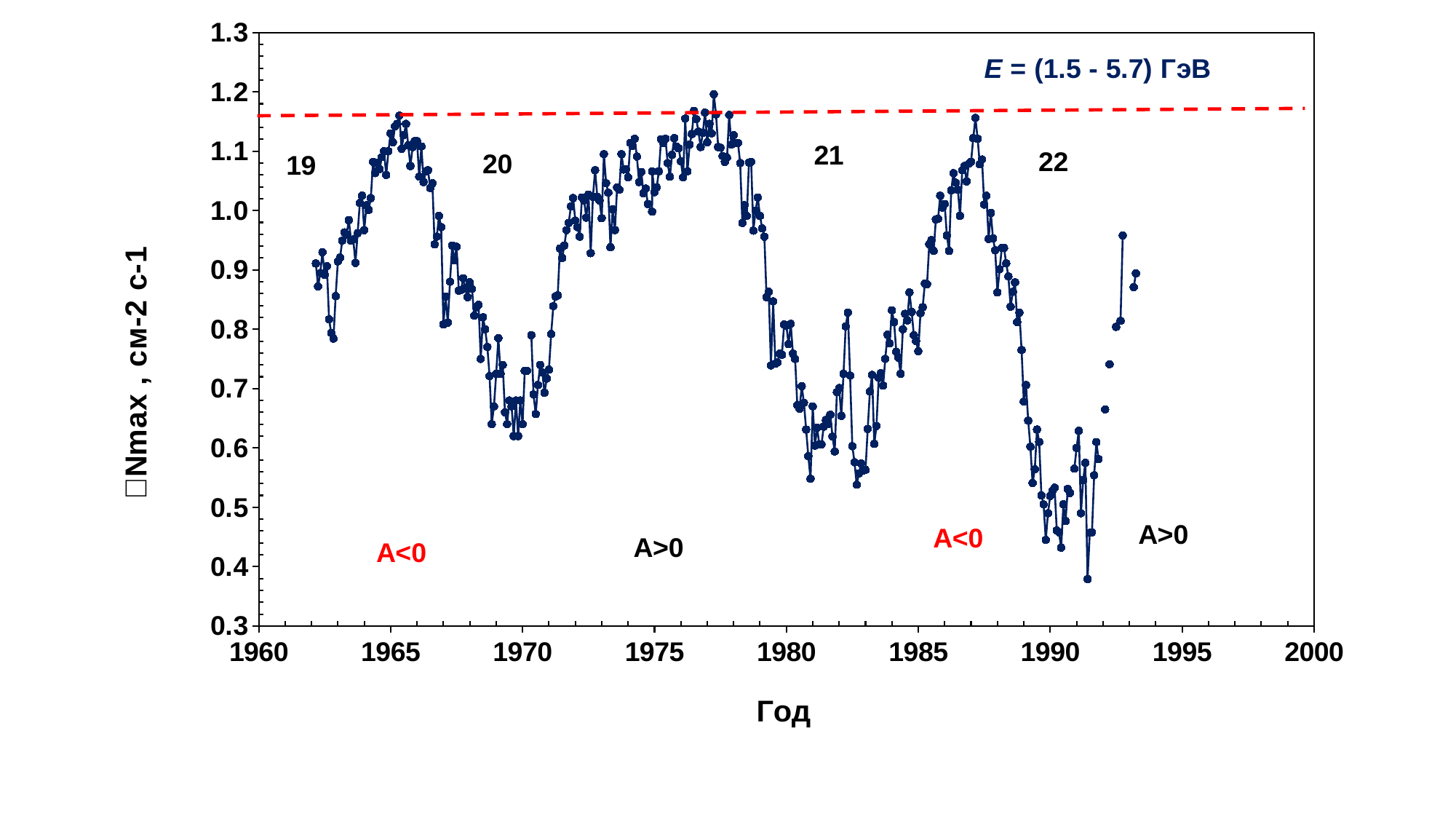
Which labelled cycle reaches the lower minimum, cycle 20 or cycle 22? 22 Is the peak value of the series around 1977 greater or less than 1.1? greater Do the values rise or fall between 1970 and 1977? rise Is the value of the series around 1970 greater or less than 0.8? less Do the values rise or fall between 1987 and 1991? fall How many numbered solar cycles (19, 20, 21, 22) are labelled on the chart? 4 What kind of chart is shown on the slide? line chart Is the lowest value of the series, reached around 1991, greater or less than 0.5? less Do the values rise or fall between 1965 and 1970? fall What energy range is written in the top right corner of the chart? E = (1.5 - 5.7) ГэВ What is the label of the x axis? Год